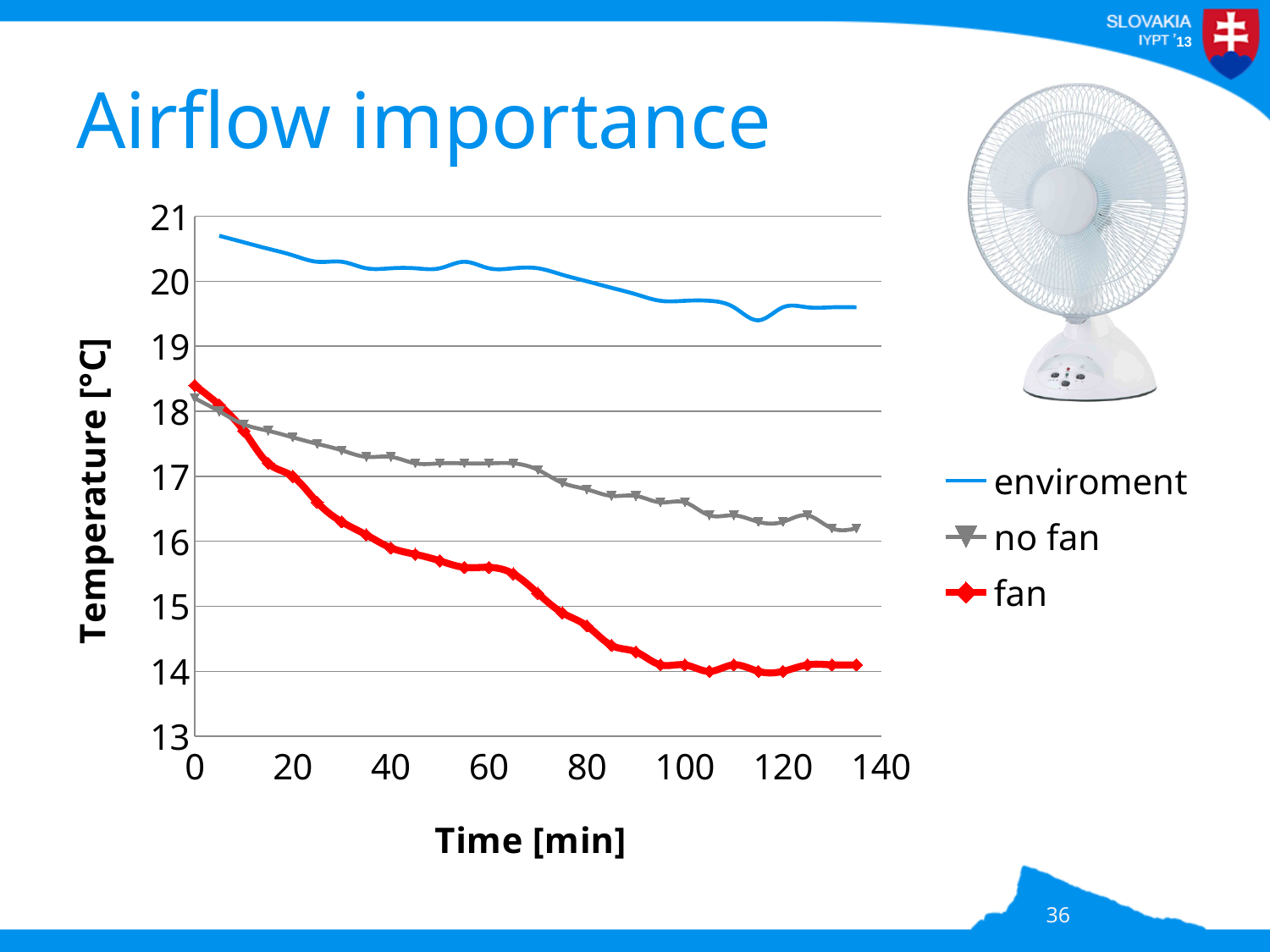
Is the temperature of the 'enviroment' series at 120 min greater or less than 20? less Does the temperature of the 'fan' series rise or fall as time increases? fall How many series does the legend list? 3 What is the label of the vertical axis? Temperature [°C] At 100 min, which series has the higher temperature, 'fan' or 'no fan'? no fan Is the temperature of the 'fan' series at 100 min greater or less than 15? less Which series has the lowest temperature at 120 min? fan Which series has the highest temperature throughout the measurement? enviroment Is the temperature of the 'fan' series at 60 min greater or less than 16? less What kind of chart is shown on the slide? line chart What are the three series named in the legend? enviroment, no fan, fan